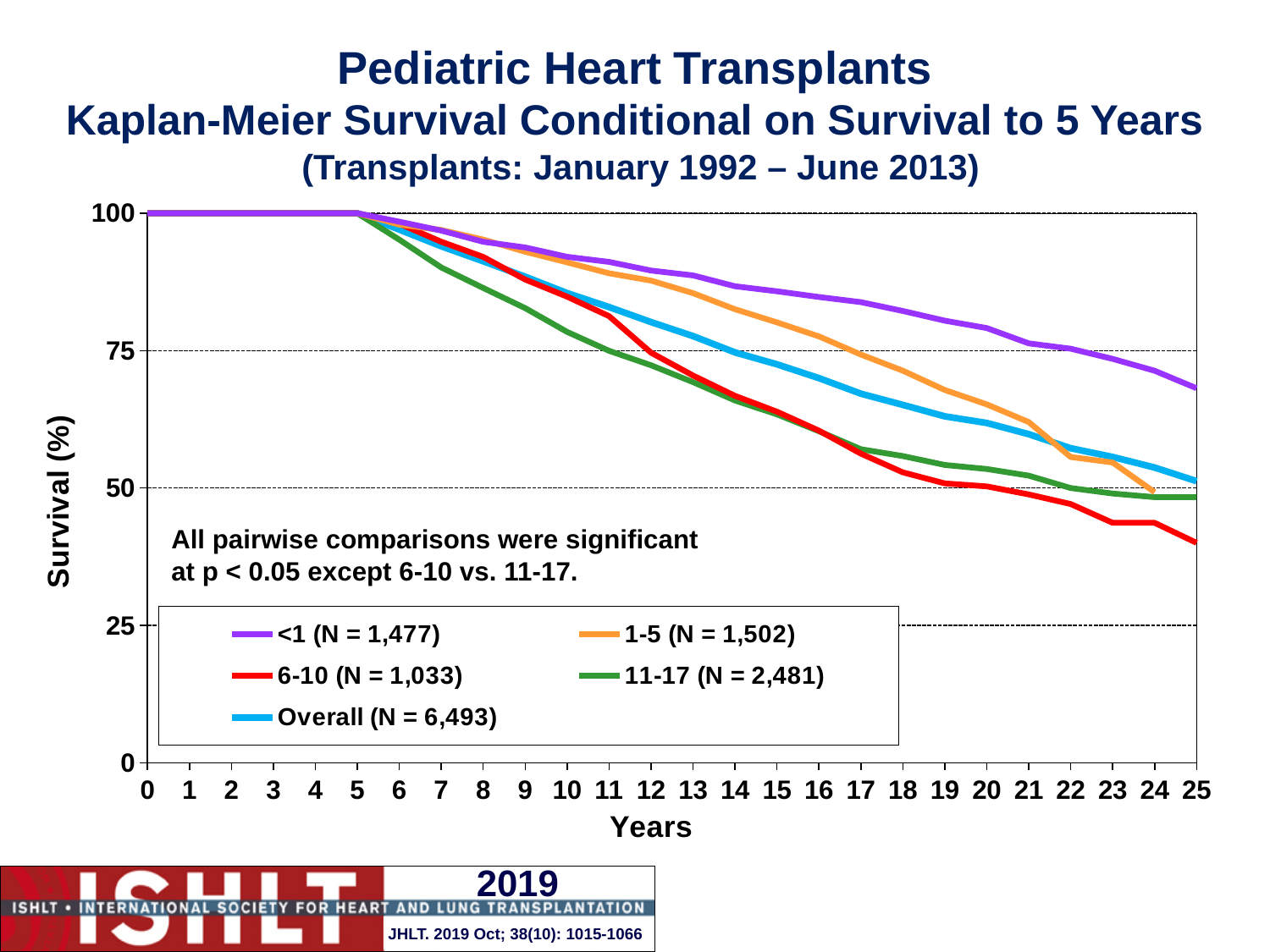
Do the survival curves rise or fall as years increase beyond year 5? fall What is the survival (%) for all groups at year 5? 100 Is the survival value for the 6-10 group at year 25 greater or less than 50? less How many series does the legend list? 5 What kind of chart is shown on the slide? line chart Is the survival value for the <1 group at year 25 greater or less than 50? greater Which group has the highest survival at year 25? <1 Is the survival value for the <1 group at year 20 greater or less than 75? greater At year 20, which group has higher survival, 1-5 or 6-10? 1-5 Which group has the lowest survival at year 25? 6-10 What is the N shown in the legend for the Overall group? 6,493